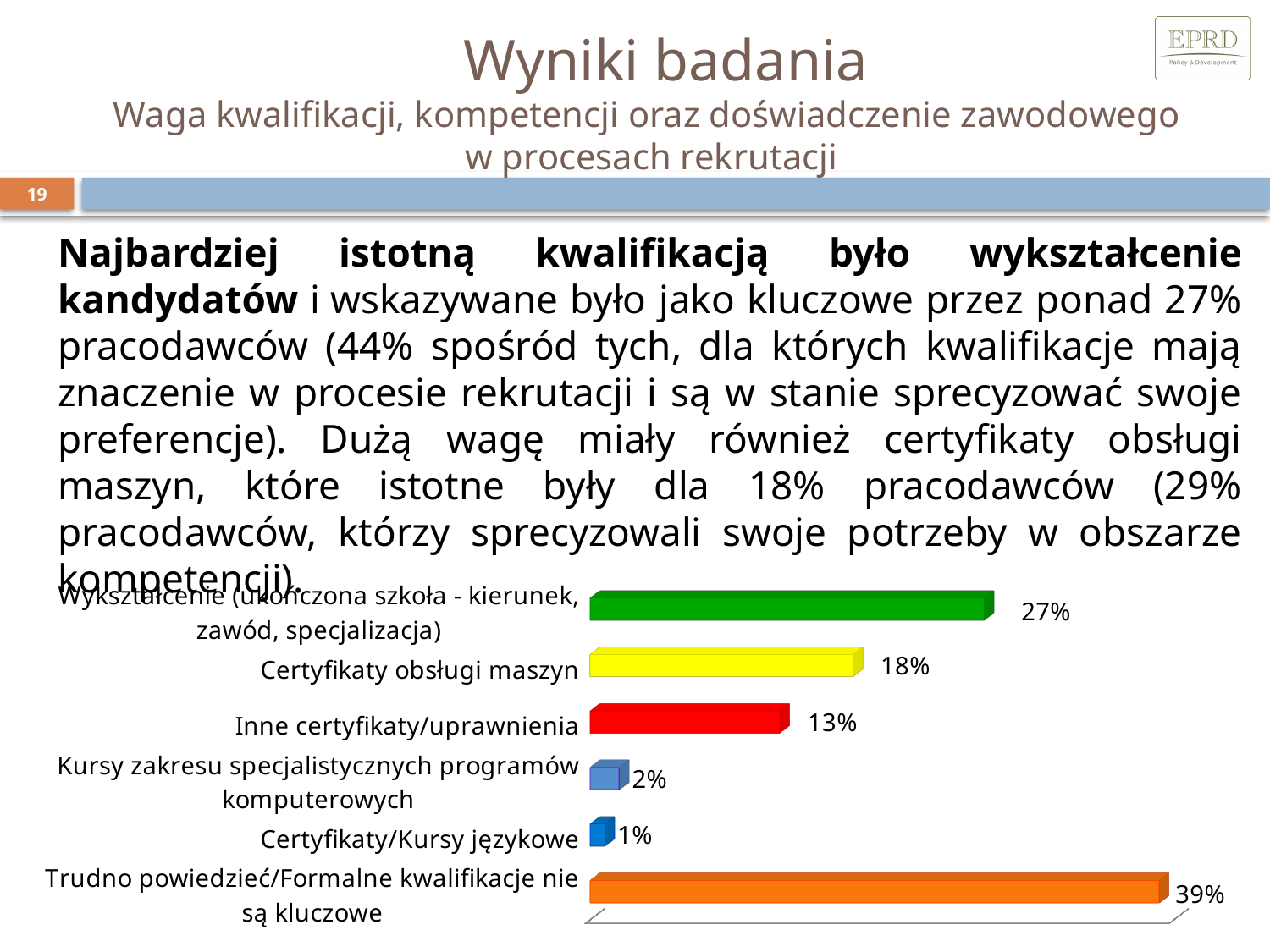
What value is shown for "Certyfikaty obsługi maszyn"? 18% What is the difference between the values for "Trudno powiedzieć/Formalne kwalifikacje nie są kluczowe" and "Inne certyfikaty/uprawnienia"? 26% What value is shown for "Wykształcenie (ukończona szkoła - kierunek, zawód, specjalizacja)"? 27% What value is shown for "Certyfikaty/Kursy językowe"? 1% What value is shown for "Kursy zakresu specjalistycznych programów komputerowych"? 2% How many categories are shown in the chart? 6 Which category has the lowest value in the chart? Certyfikaty/Kursy językowe Which is larger: the value for "Certyfikaty obsługi maszyn" or the value for "Inne certyfikaty/uprawnienia"? Certyfikaty obsługi maszyn What is the difference between the values for "Wykształcenie (ukończona szkoła - kierunek, zawód, specjalizacja)" and "Certyfikaty obsługi maszyn"? 9% What type of chart is shown on the slide? Bar chart What value is shown for "Inne certyfikaty/uprawnienia"? 13% Which category has the highest value in the chart? Trudno powiedzieć/Formalne kwalifikacje nie są kluczowe